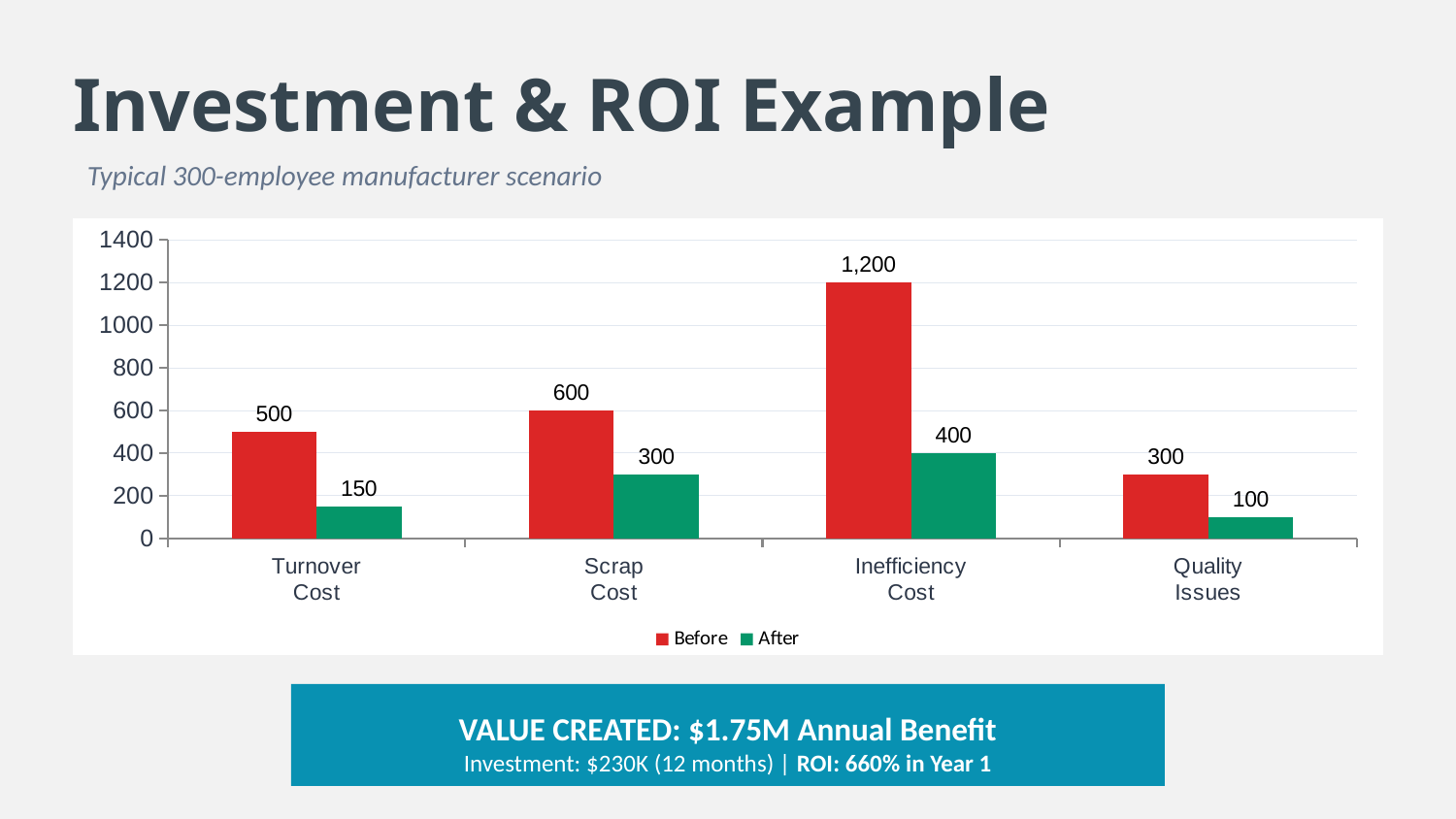
Which colour represents the After series in the legend? Green What kind of chart is shown on the slide? Bar chart What is the Before value for Inefficiency Cost? 1,200 Which category has the lowest After value? Quality Issues What is the After value for Scrap Cost? 300 What is the After value for Turnover Cost? 150 How many series does the legend list? 2 How many categories are shown on the x axis? 4 Which category has the highest Before value? Inefficiency Cost What is the difference between the Before and After values for Inefficiency Cost? 800 Which is larger: the Before value for Scrap Cost or the Before value for Turnover Cost? Scrap Cost What is the Before value for Quality Issues? 300